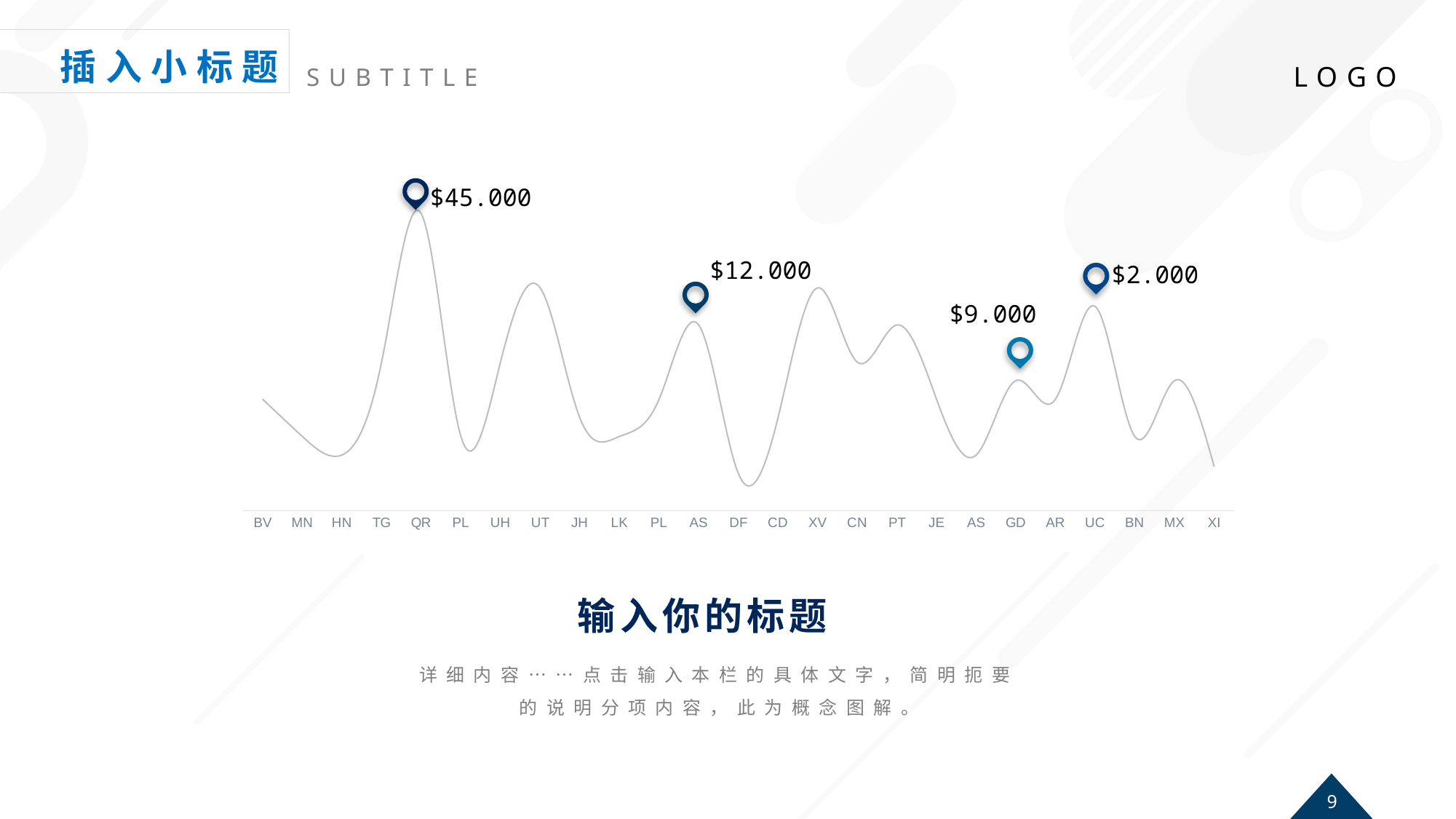
Among the four labelled values, which is the smallest? $2.000 How many data points on the line carry a printed value label? 4 What value is labelled at category UC? $2.000 Which category carries the largest labelled value? QR What value is labelled at category QR? $45.000 What kind of chart is shown on the slide? line chart How many categories are listed along the x axis? 25 What is the difference between the labelled values at QR and at the first AS? $33.000 Which labelled value is larger, the one at GD or the one at UC? GD What value is labelled at category GD? $9.000 What value is labelled at the first AS category (between PL and DF)? $12.000 Does the line rise or fall from QR to PL? fall